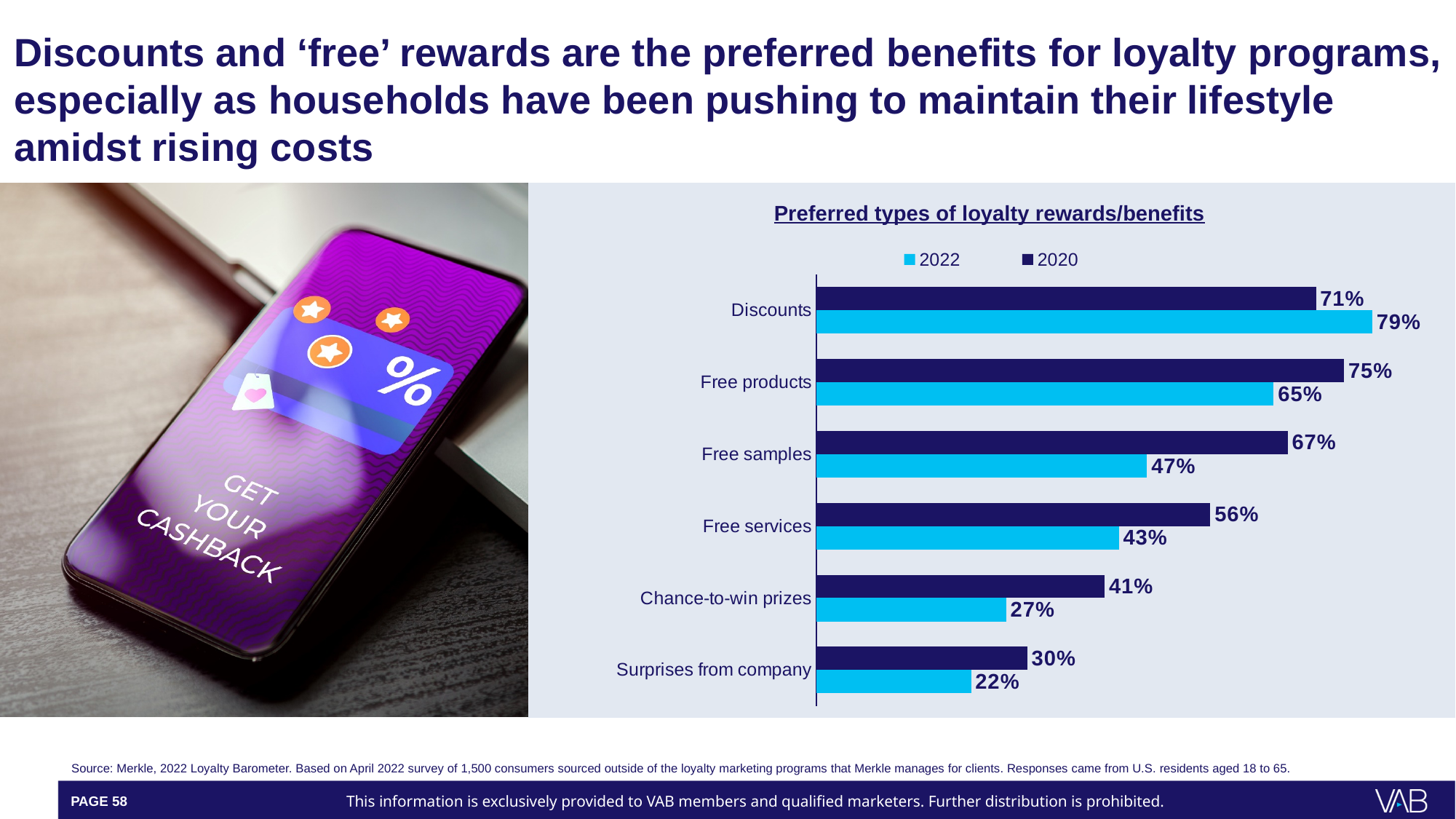
What is the 2022 value for Chance-to-win prizes? 27% What kind of chart is shown on the slide? Bar chart Which category has the highest 2022 value? Discounts What is the difference between the 2022 and 2020 values for Discounts? 8 percentage points What is the title of the chart? Preferred types of loyalty rewards/benefits How many series does the legend list? 2 Which is larger for Free products: the 2020 value or the 2022 value? 2020 What is the 2020 value for Free samples? 67% What is the 2022 value for Discounts? 79% How many categories are shown in the chart? 6 What is the difference between the 2020 and 2022 values for Free samples? 20 percentage points Which category has the lowest 2020 value? Surprises from company